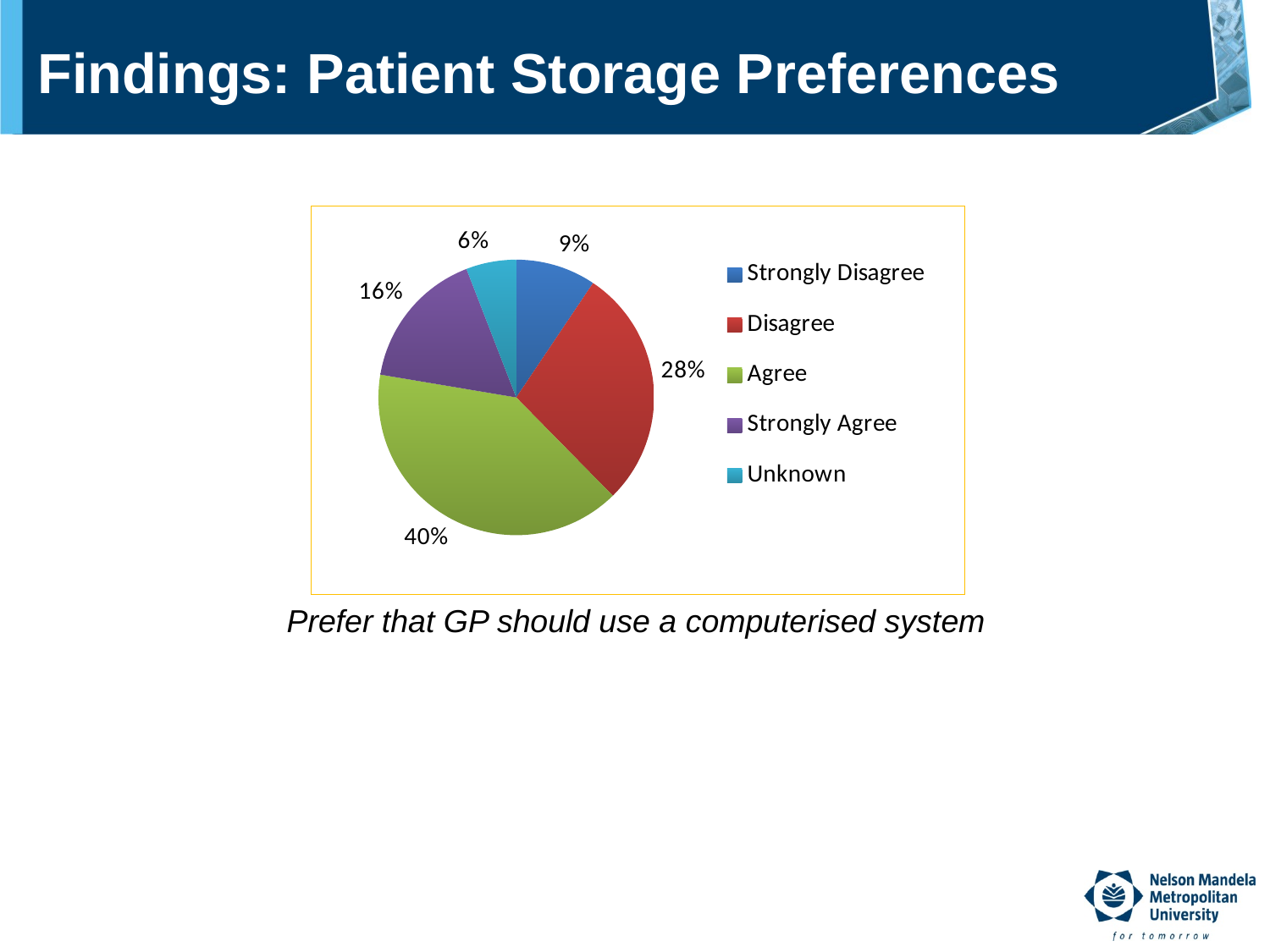
Which is larger, the share for Disagree or the share for Strongly Agree? Disagree What percentage of patients answered Strongly Disagree? 9% What percentage is labelled Unknown? 6% Which response category has the largest share of the pie? Agree How many categories does the legend list? 5 What is the difference in percentage points between Agree and Disagree? 12 What kind of chart is shown on the slide? pie chart Which response category has the smallest share of the pie? Unknown What colour is the Agree slice? green What percentage of patients answered Disagree? 28% What percentage of patients answered Agree? 40% What percentage of patients answered Strongly Agree? 16%